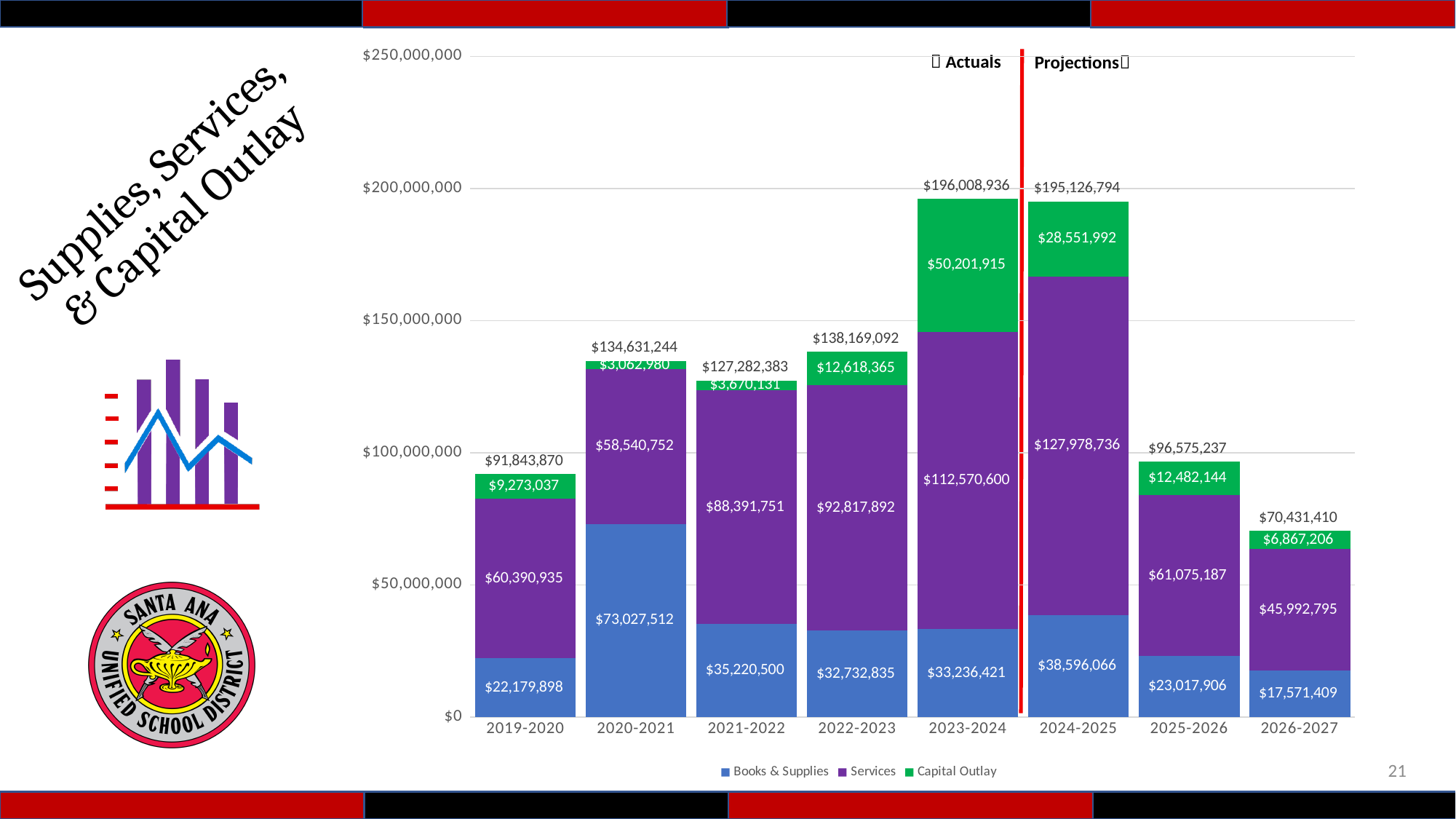
How many series does the legend list? 3 Which is larger, Books & Supplies in 2021-2022 or Books & Supplies in 2022-2023? 2021-2022 What is the value for Books & Supplies in 2020-2021? $73,027,512 What is the total of the stacked bar for 2026-2027? $70,431,410 What is the difference between Capital Outlay in 2023-2024 and Capital Outlay in 2024-2025? $21,649,923 Which year has the highest total? 2023-2024 Which year has the lowest total? 2026-2027 How many years are shown on the x axis? 8 What is the value for Services in 2023-2024? $112,570,600 What is the total of the stacked bar for 2023-2024? $196,008,936 What is the value for Capital Outlay in 2024-2025? $28,551,992 Is the total for 2025-2026 greater or less than $100,000,000? less